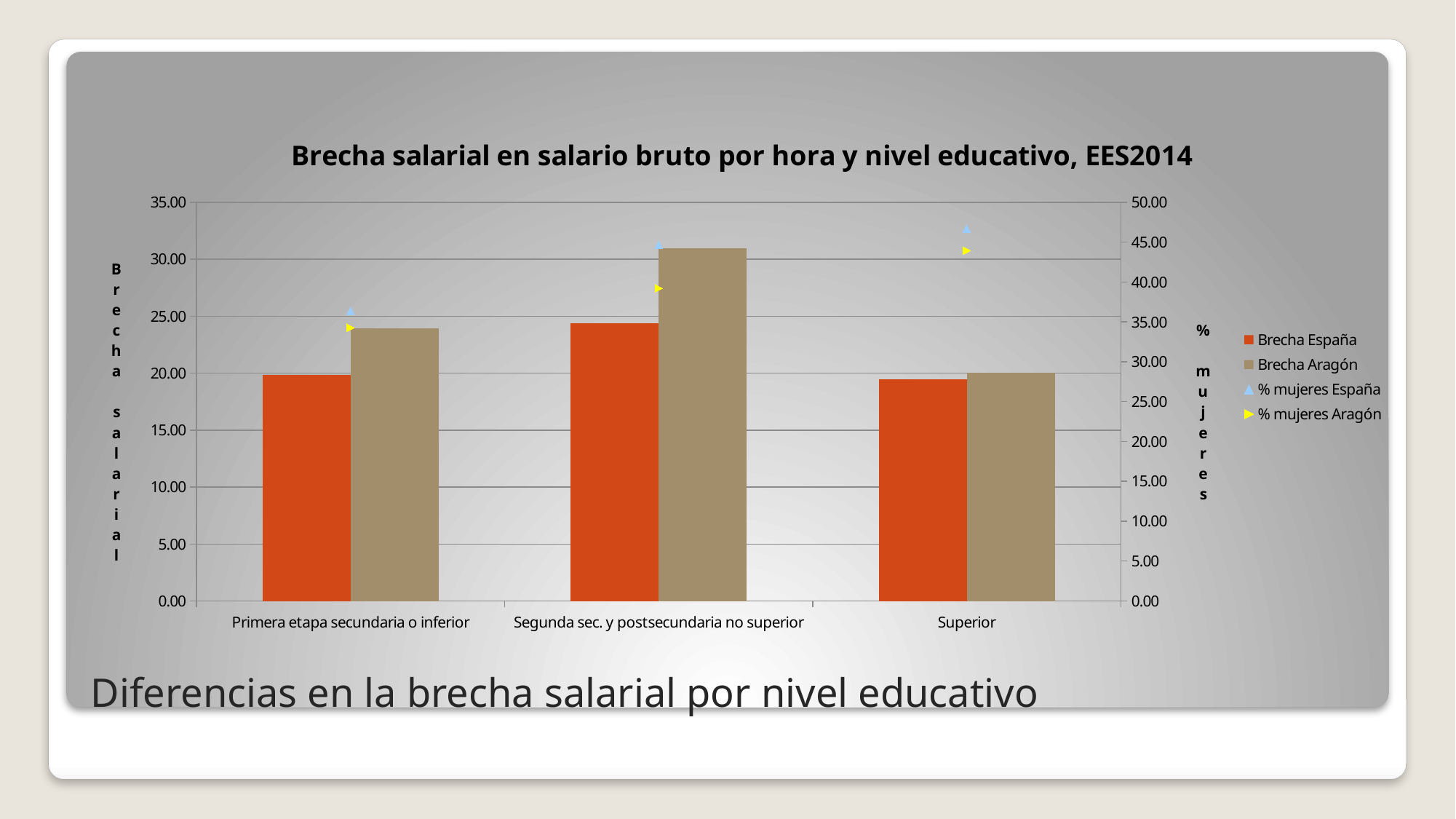
How many series does the legend list? 4 Is the Brecha Aragón value for Segunda sec. y postsecundaria no superior greater or less than 25.00? greater Do the % mujeres España values rise or fall from Primera etapa secundaria o inferior to Superior? rise For which category is the Brecha Aragón bar lowest? Superior How many education-level categories are shown on the x axis? 3 Is the % mujeres España value for Superior greater or less than 40.00 on the right axis? greater What kind of chart is used to plot the Brecha España and Brecha Aragón series? bar chart For which category is the Brecha España bar highest? Segunda sec. y postsecundaria no superior For which category is the Brecha Aragón bar highest? Segunda sec. y postsecundaria no superior For Primera etapa secundaria o inferior, which is larger: Brecha España or Brecha Aragón? Brecha Aragón Is the Brecha Aragón value for Superior greater or less than 25.00? less What is the title of the chart? Brecha salarial en salario bruto por hora y nivel educativo, EES2014